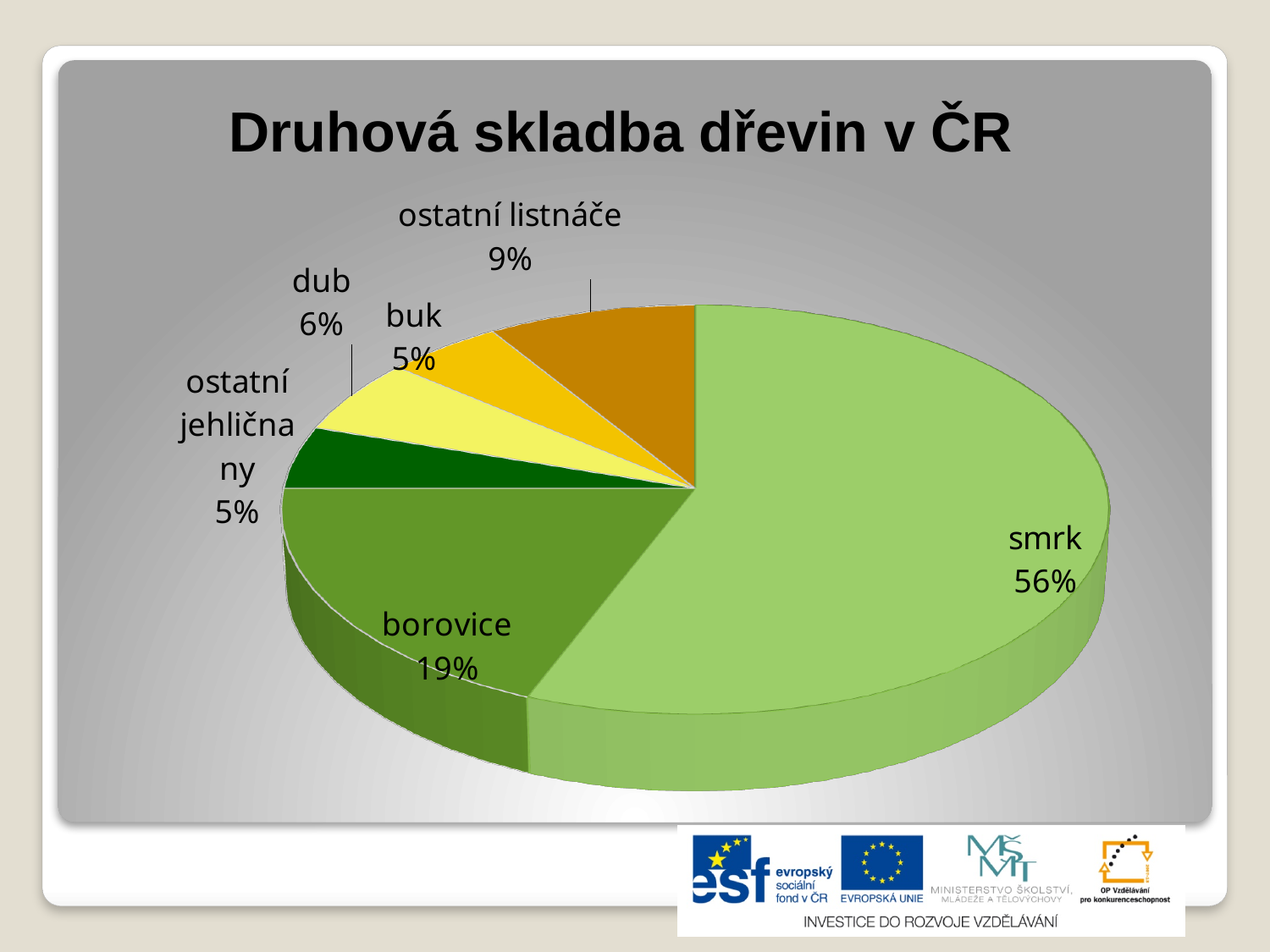
What is the difference between the shares of smrk and borovice? 37% Which is larger, the share of dub or the share of buk? dub What share of the pie does borovice have? 19% What kind of chart is shown on the slide? pie chart What share of the pie does ostatní listnáče have? 9% How many slices does the pie chart have? 6 Which is larger, the share of ostatní listnáče or the share of dub? ostatní listnáče What share of the pie does dub have? 6% What is the title of the chart? Druhová skladba dřevin v ČR What is the combined share of buk and ostatní jehličnany? 10% What share of the pie does smrk have? 56% Which category has the largest slice of the pie? smrk